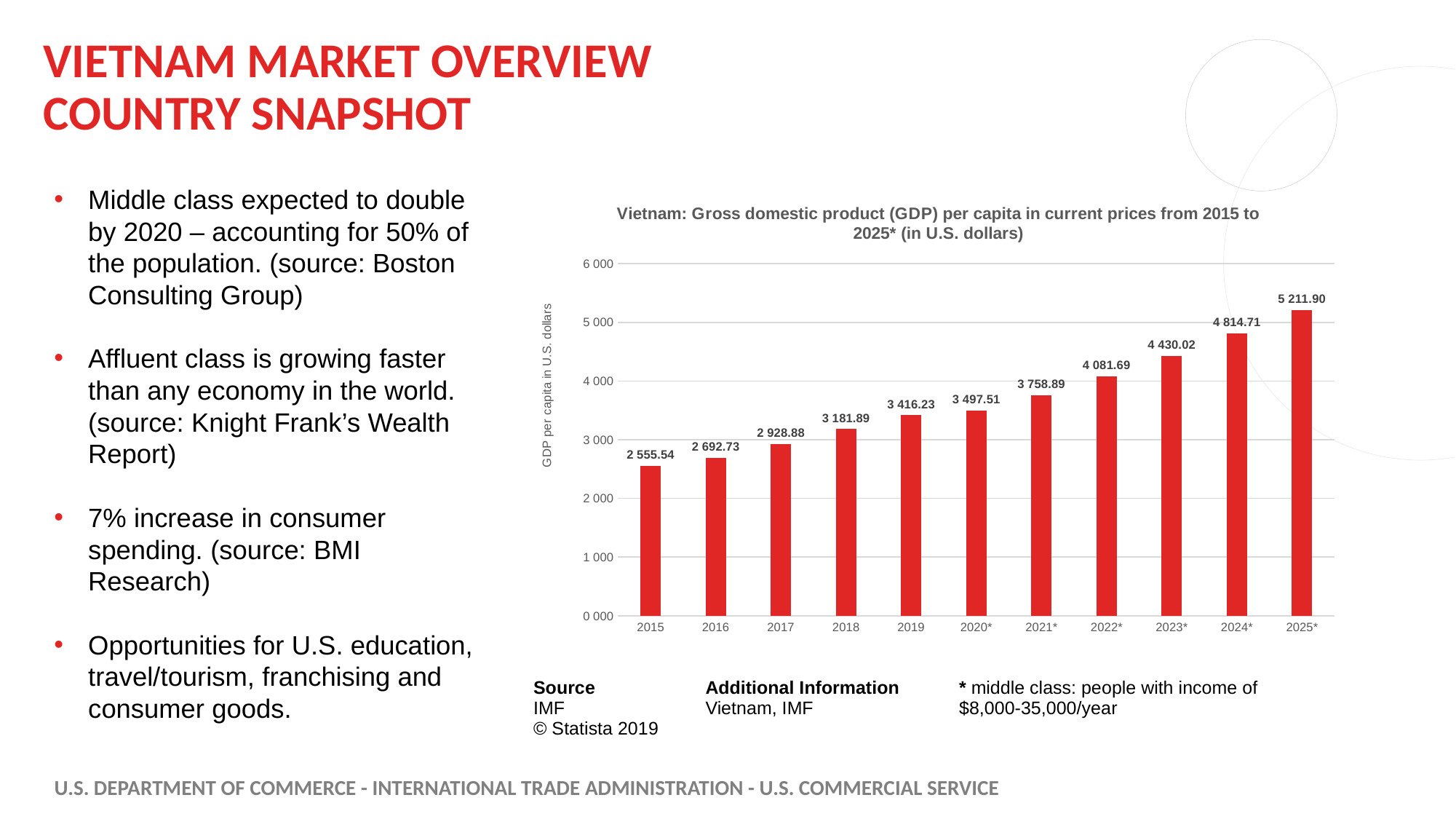
Do the GDP per capita values rise or fall from 2015 to 2025*? Rise How many years (bars) are shown in the chart? 11 What is the difference between the GDP per capita values for 2024* and 2023*? 384.69 Which year has the highest GDP per capita in the chart? 2025* Which year has the lowest GDP per capita in the chart? 2015 What is the GDP per capita value shown for 2022*? 4 081.69 What is the GDP per capita value shown for 2019? 3 416.23 Which is larger, the GDP per capita for 2018 or for 2021*? 2021* What kind of chart is used to show Vietnam's GDP per capita? Bar chart What is the difference between the GDP per capita values for 2025* and 2015? 2 656.36 What is the GDP per capita value shown for 2015? 2 555.54 What is the GDP per capita value shown for 2025*? 5 211.90